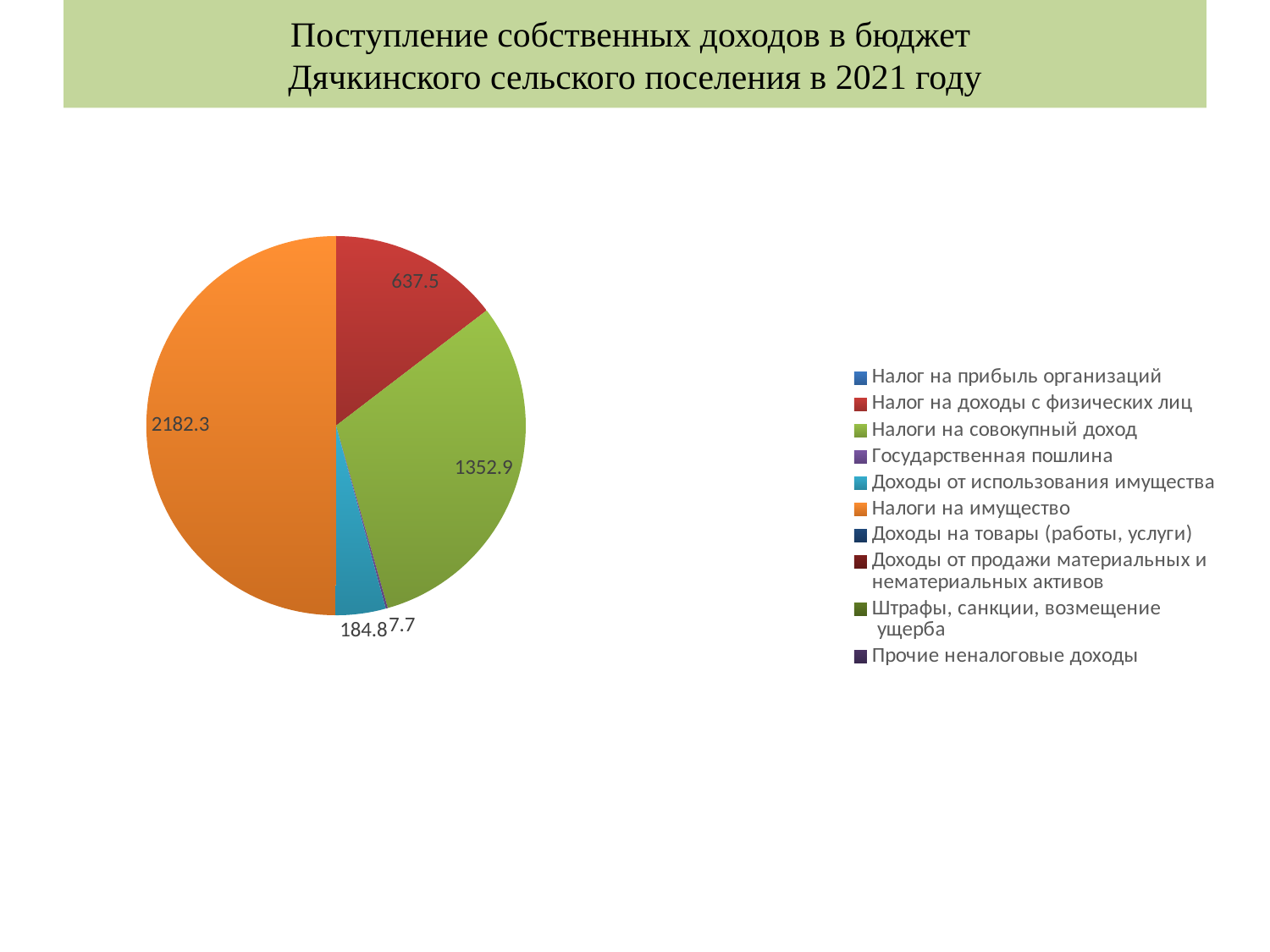
What is the value for Налог на доходы с физических лиц? 637.5 What is the difference between the values for Налоги на имущество and Налоги на совокупный доход? 829.4 What is the value for Налоги на имущество? 2182.3 What is the value for Доходы от использования имущества? 184.8 Which is larger, the value for Налог на доходы с физических лиц or the value for Доходы от использования имущества? Налог на доходы с физических лиц What is the difference between the values for Налоги на совокупный доход and Налог на доходы с физических лиц? 715.4 What is the value for Государственная пошлина? 7.7 What is the value for Налоги на совокупный доход? 1352.9 How many entries does the legend list? 10 What type of chart is shown on the slide? pie chart What colour is the slice for Налоги на совокупный доход? green Which category has the largest slice of the pie? Налоги на имущество